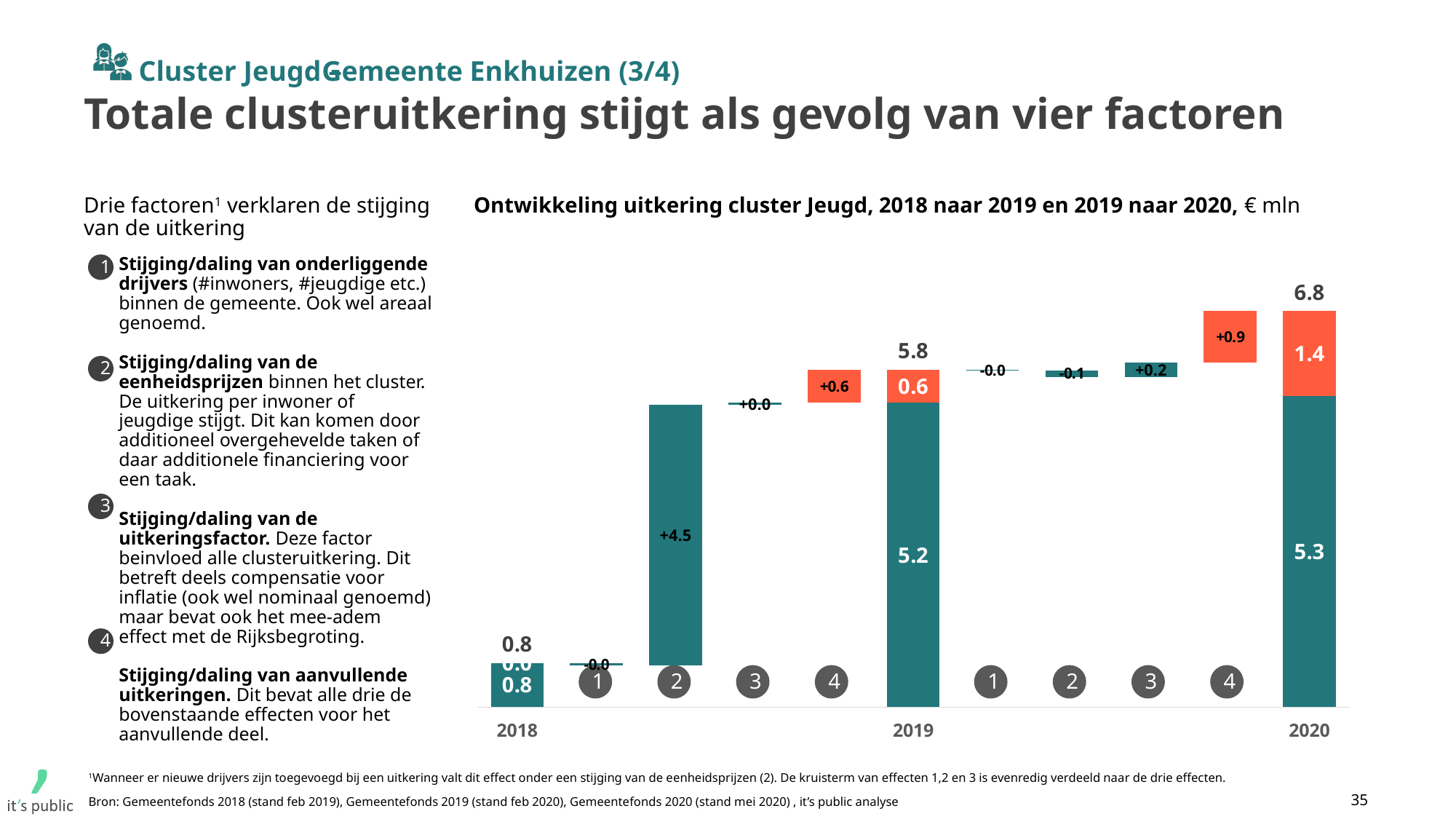
What is the total uitkering for cluster Jeugd in 2019 shown above the bar? 5.8 What is the total uitkering for cluster Jeugd in 2020 shown above the bar? 6.8 Which year has the highest total uitkering in the chart? 2020 What is the difference between the 2020 total (6.8) and the 2019 total (5.8)? 1.0 Do the yearly totals rise or fall from 2018 to 2020? Rise Which factor contributes the largest change between 2018 and 2019? Factor 2 What is the value of factor 2 in the change from 2019 to 2020? -0.1 What is the value of the orange (upper) segment of the 2019 bar? 0.6 What is the value of factor 4 in the change from 2019 to 2020? +0.9 What is the value of factor 2 in the change from 2018 to 2019? +4.5 What is the total uitkering for cluster Jeugd in 2018 shown above the bar? 0.8 What is the value of the teal (lower) segment of the 2020 bar? 5.3